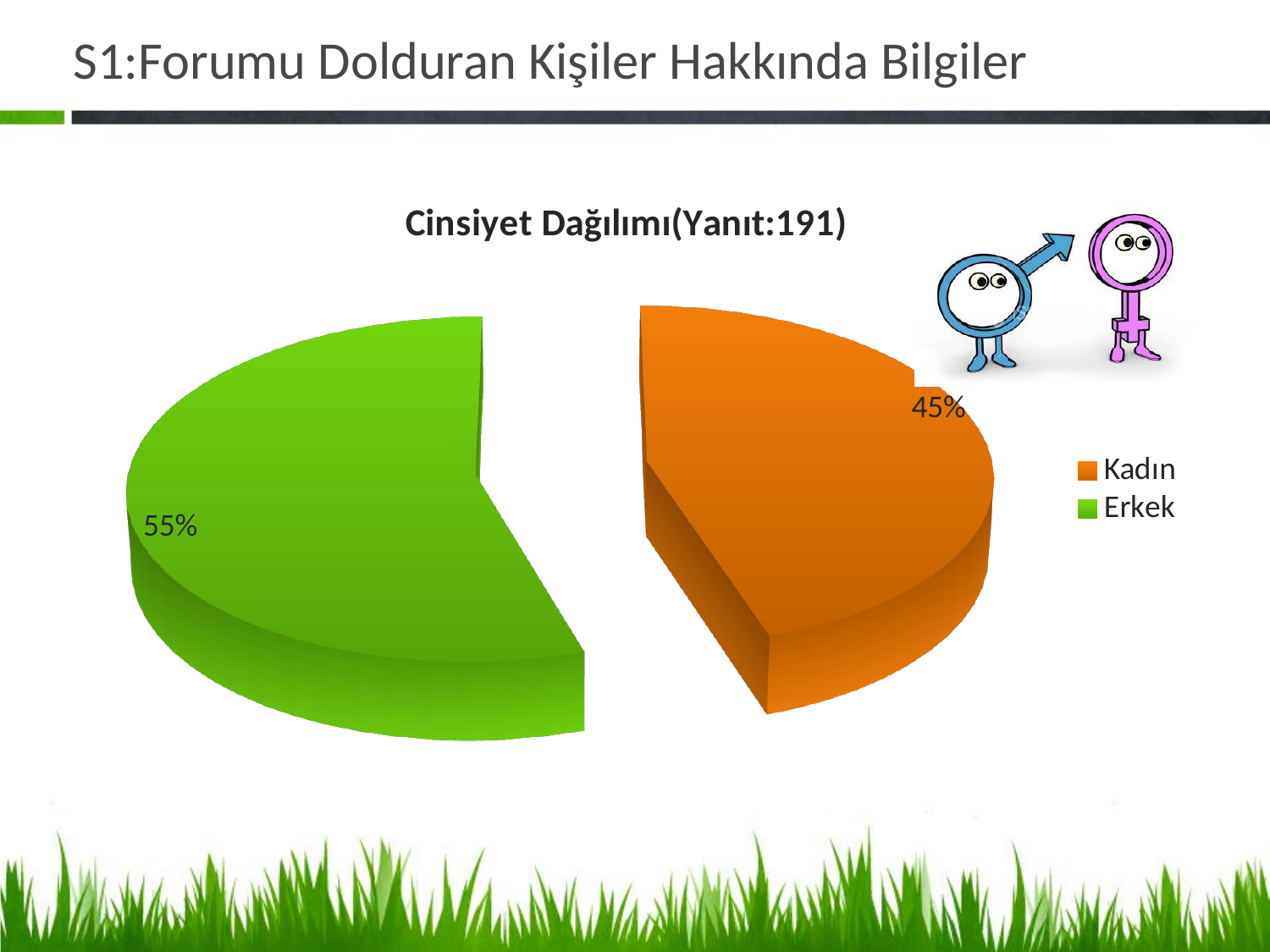
What percentage of the pie is Kadın? 45% How many slices does the pie chart have? 2 How many entries does the legend list? 2 What is the difference in percentage points between the Erkek and Kadın shares? 10 What colour is the Kadın slice? orange How many responses (Yanıt) does the chart title state? 191 Which category has the smallest share of the pie? Kadın What kind of chart is shown on the slide? pie chart What is the chart's title? Cinsiyet Dağılımı(Yanıt:191) Which is larger, the share for Kadın or the share for Erkek? Erkek Which category has the largest share of the pie? Erkek What percentage of the pie is Erkek? 55%